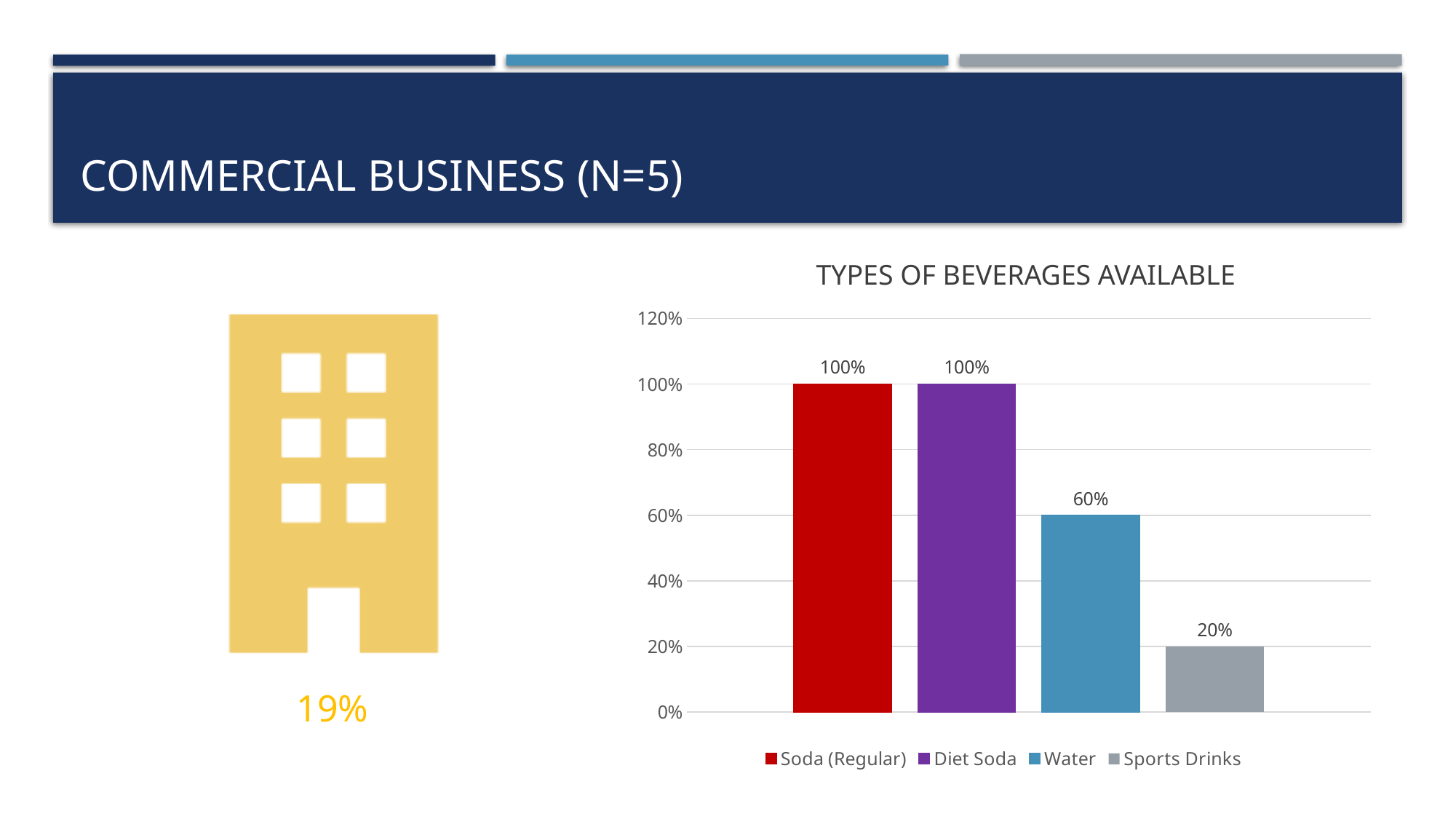
How many entries does the chart legend list? 4 What is the value for Water in the Types of Beverages Available chart? 60% Which is larger, the value for Water or the value for Sports Drinks? Water What is the title of the chart on the slide? Types of Beverages Available Which beverage type has the lowest value in the chart? Sports Drinks What is the difference between the values for Water and Sports Drinks? 40% What is the value for Sports Drinks in the Types of Beverages Available chart? 20% Is the value for Water greater or less than 80%? less What kind of chart is shown on the slide? Bar chart What is the value for Diet Soda in the Types of Beverages Available chart? 100% What is the difference between the values for Soda (Regular) and Water? 40% How many beverage types are shown in the chart? 4